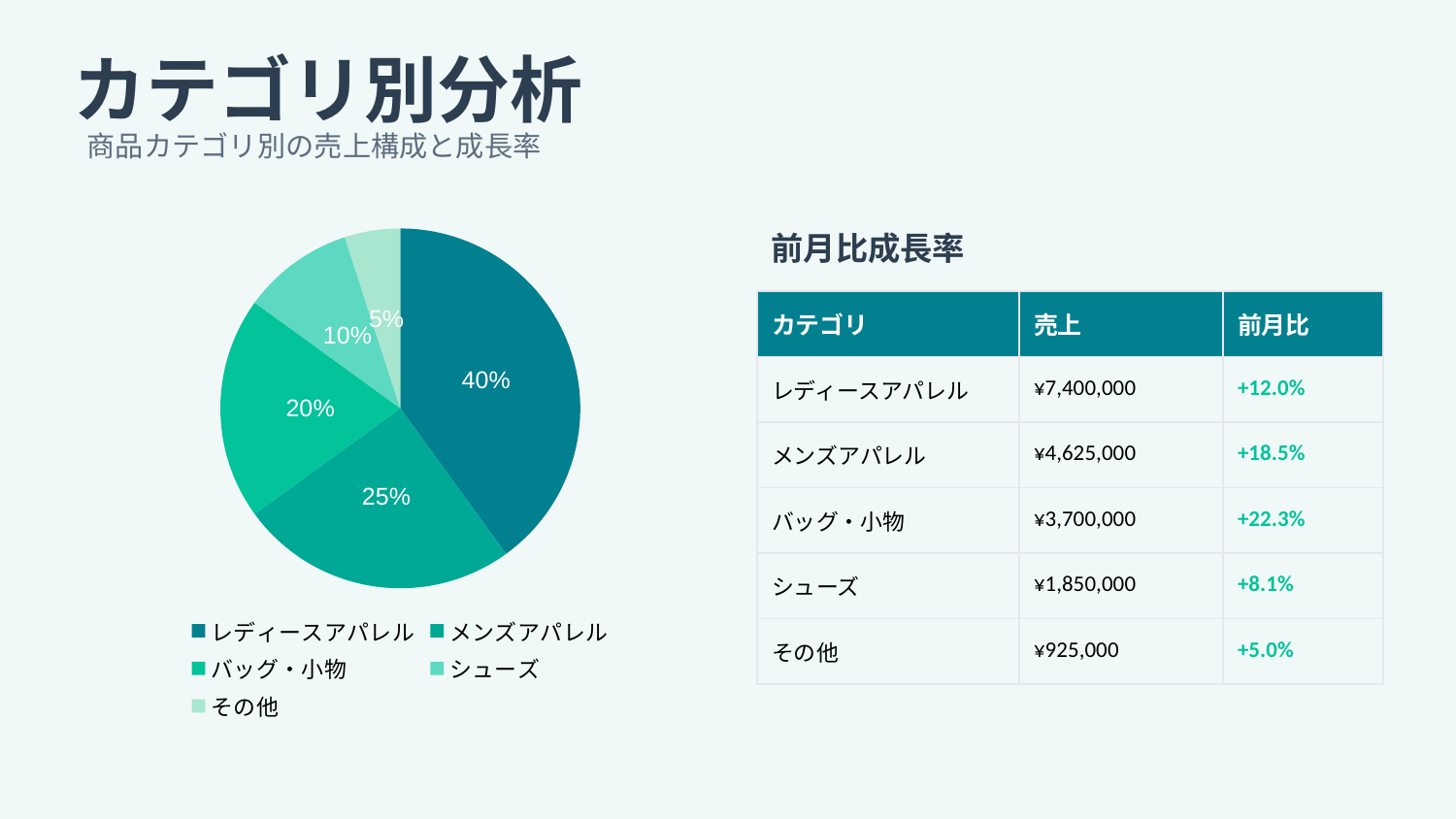
Which category has the smallest slice in the pie chart? その他 What is the difference in percentage points between the レディースアパレル slice and the メンズアパレル slice? 15% What share of the pie chart does シューズ represent? 10% Which slice is larger in the pie chart, バッグ・小物 or シューズ? バッグ・小物 What kind of chart is shown on the slide? Pie chart What share of the pie chart does その他 represent? 5% How many entries does the pie chart's legend list? 5 Which category has the largest slice in the pie chart? レディースアパレル What share of the pie chart does バッグ・小物 represent? 20% How many categories are shown in the pie chart? 5